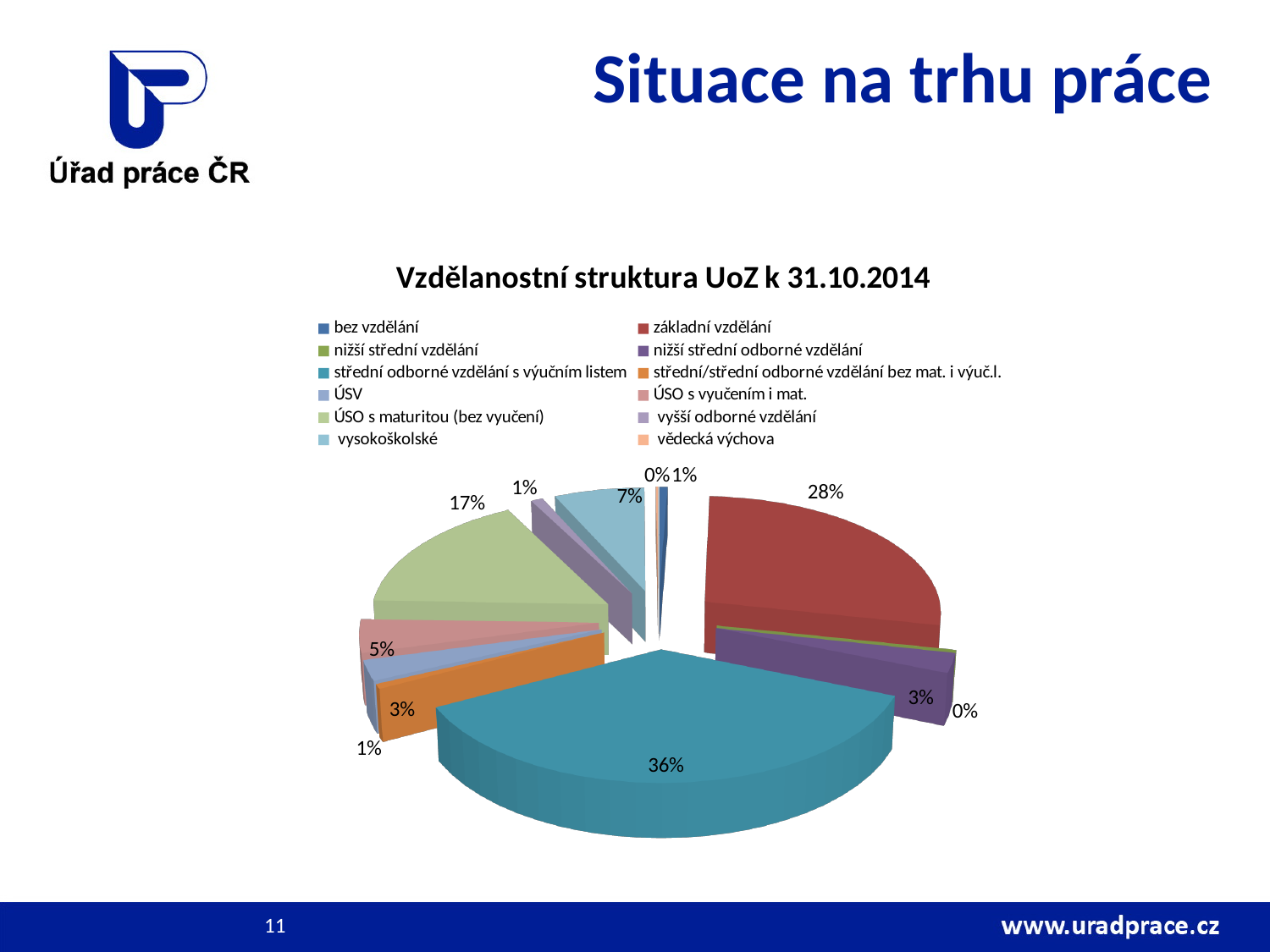
What is the combined share of 'základní vzdělání' and 'vysokoškolské'? 35% Which category has the largest slice of the pie? střední odborné vzdělání s výučním listem What share of the pie does 'ÚSO s vyučením i mat.' have? 5% What share of the pie does 'vysokoškolské' have? 7% What share of the pie does 'ÚSO s maturitou (bez vyučení)' have? 17% What is the title of the chart? Vzdělanostní struktura UoZ k 31.10.2014 What type of chart is shown on the slide? pie chart How many categories does the legend of the pie chart list? 12 Which is larger: the share for 'základní vzdělání' or the share for 'ÚSO s maturitou (bez vyučení)'? základní vzdělání What is the difference in percentage points between the share for 'střední odborné vzdělání s výučním listem' and the share for 'základní vzdělání'? 8%